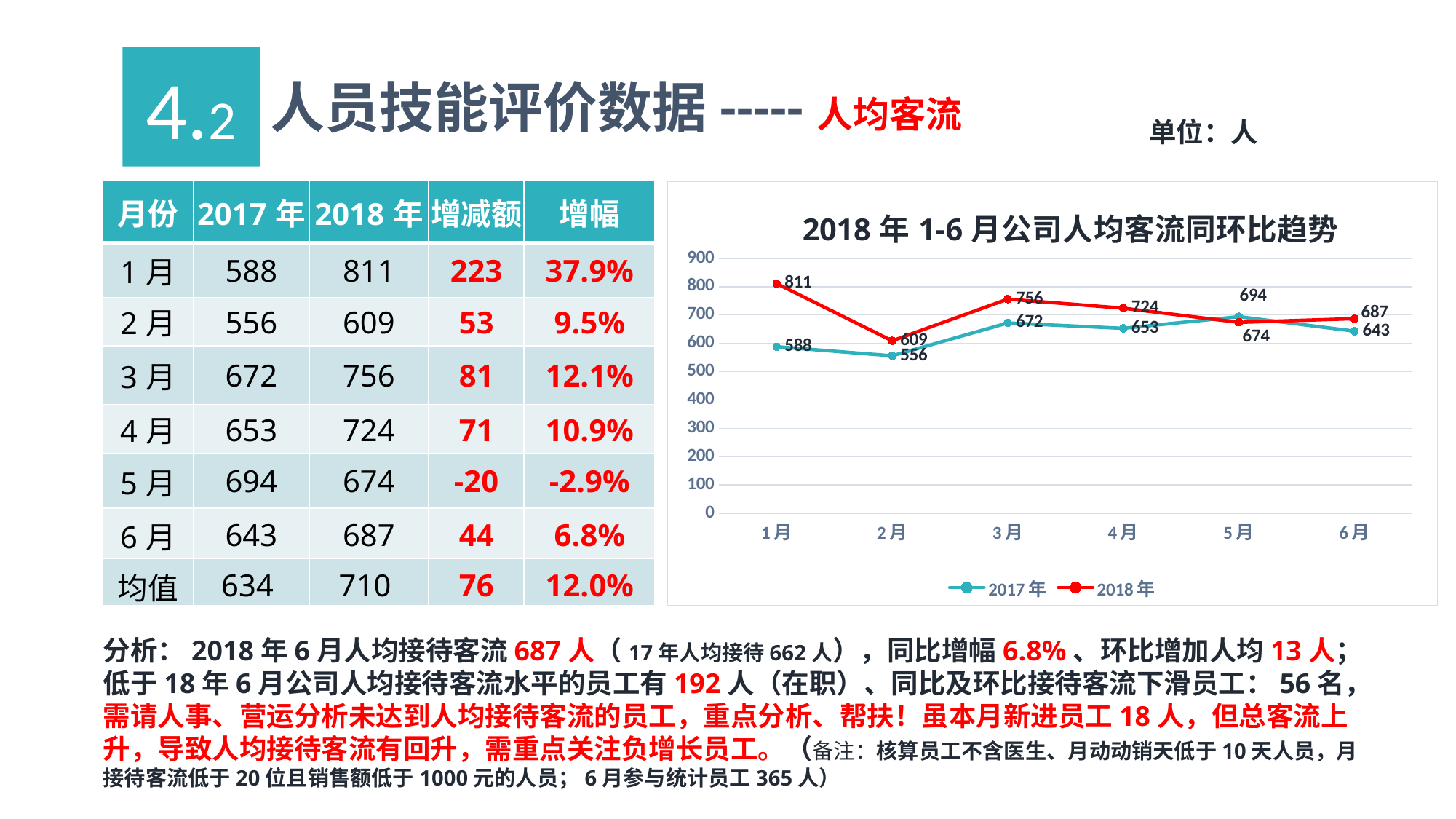
Is the value for 2018年 in 2月 greater or less than 700? less Does the 2018年 series rise or fall from 1月 to 2月? fall What kind of chart is shown? line chart Which month has the highest value for the 2018年 series? 1月 What is the title of the chart? 2018年1-6月公司人均客流同环比趋势 What is the value for 2018年 in 1月? 811 What is the difference between the 2018年 and 2017年 values in 3月? 84 In 5月, which series has the larger value, 2017年 or 2018年? 2017年 How many series does the legend list? 2 What is the value for 2017年 in 5月? 694 How many months are plotted on the x axis? 6 Which month has the lowest value for the 2017年 series? 2月